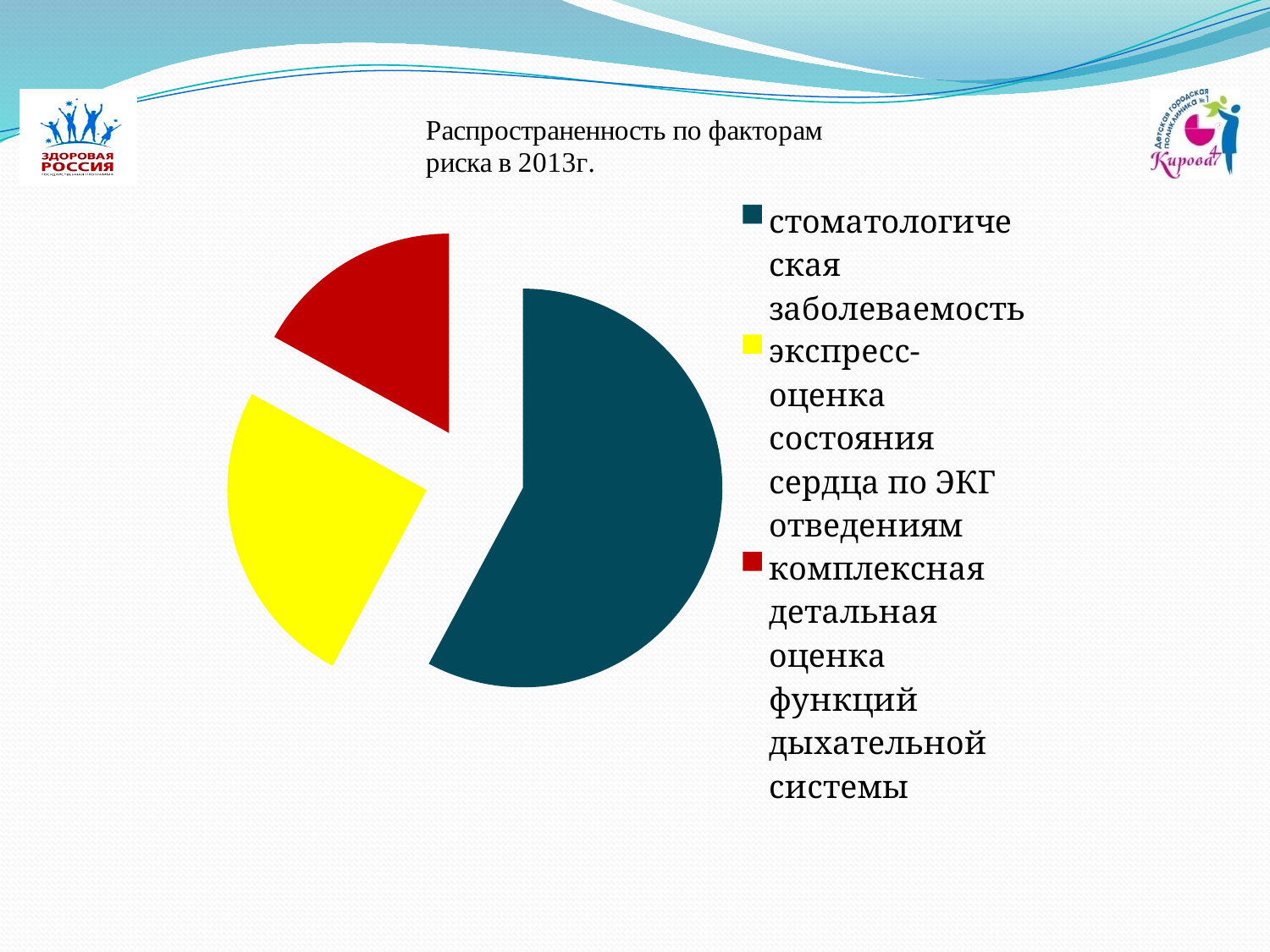
What colour is the slice for экспресс-оценка состояния сердца по ЭКГ отведениям? yellow What is the title of the chart on the slide? Распространенность по факторам риска в 2013г. Which slice is larger: экспресс-оценка состояния сердца по ЭКГ отведениям or комплексная детальная оценка функций дыхательной системы? экспресс-оценка состояния сердца по ЭКГ отведениям Which category has the largest slice of the pie chart? стоматологическая заболеваемость Which slice is larger: стоматологическая заболеваемость or экспресс-оценка состояния сердца по ЭКГ отведениям? стоматологическая заболеваемость How many slices does the pie chart have? 3 What kind of chart is shown on the slide? pie chart How many entries does the legend of the pie chart list? 3 Which category has the smallest slice of the pie chart? комплексная детальная оценка функций дыхательной системы